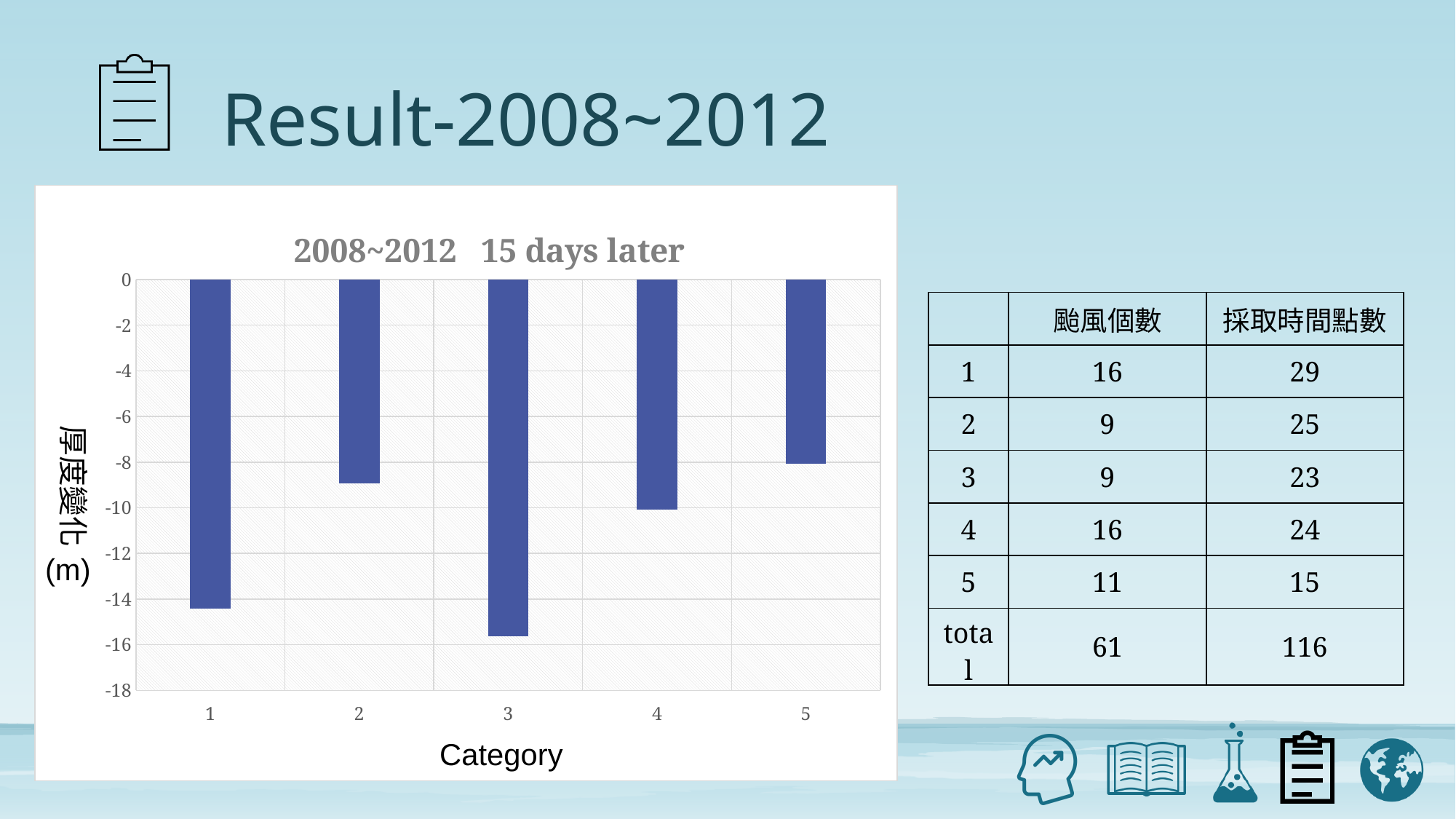
Which category has the shortest bar (the smallest negative thickness change)? 5 What kind of chart is shown on the slide? bar chart How many categories are plotted on the x axis of the chart? 5 What is the x-axis label of the chart? Category Is the value for category 4 greater or less than -12? greater Which bar extends further below zero, category 3 or category 4? category 3 Is the value for category 2 greater or less than -10? greater Is the value for category 1 greater or less than -12? less Which bar extends further below zero, category 1 or category 2? category 1 What is the title of the chart? 2008~2012 15 days later Which category has the longest bar (the largest negative thickness change)? 3